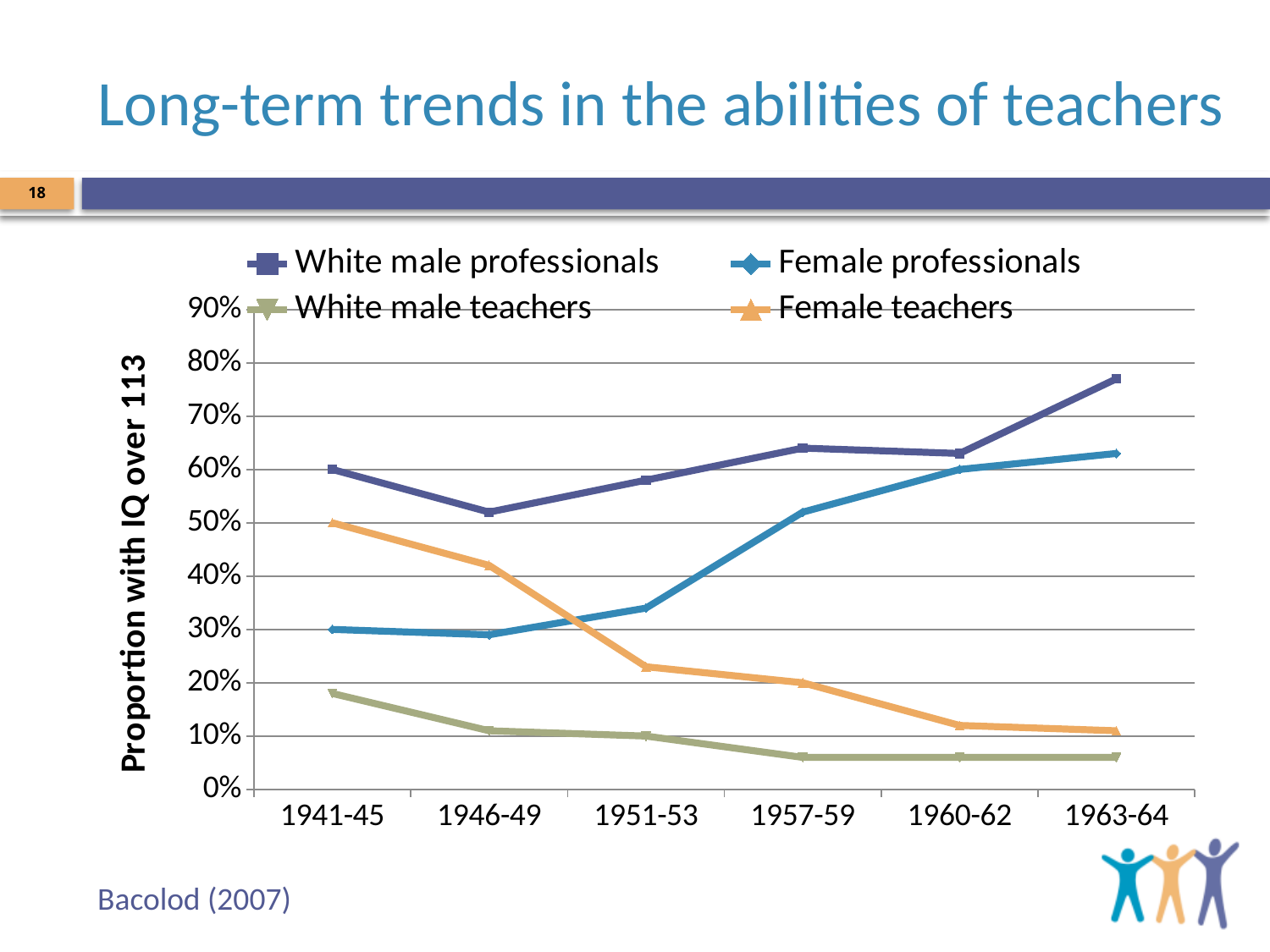
How many series does the legend list? 4 Is the value for White male professionals in 1963-64 greater or less than 70%? greater In 1946-49, which is larger: Female teachers or Female professionals? Female teachers Do the values for Female professionals rise or fall from 1946-49 to 1963-64? rise What kind of chart is shown on the slide? Line chart Which series has the lowest value in 1941-45? White male teachers Is the value for Female teachers in 1951-53 greater or less than 30%? less Is the value for White male teachers in 1957-59 greater or less than 10%? less Do the values for White male teachers rise or fall from 1941-45 to 1963-64? fall How many time periods are shown on the x axis? 6 What is the y-axis title of the chart? Proportion with IQ over 113 Which series has the highest value in 1963-64? White male professionals